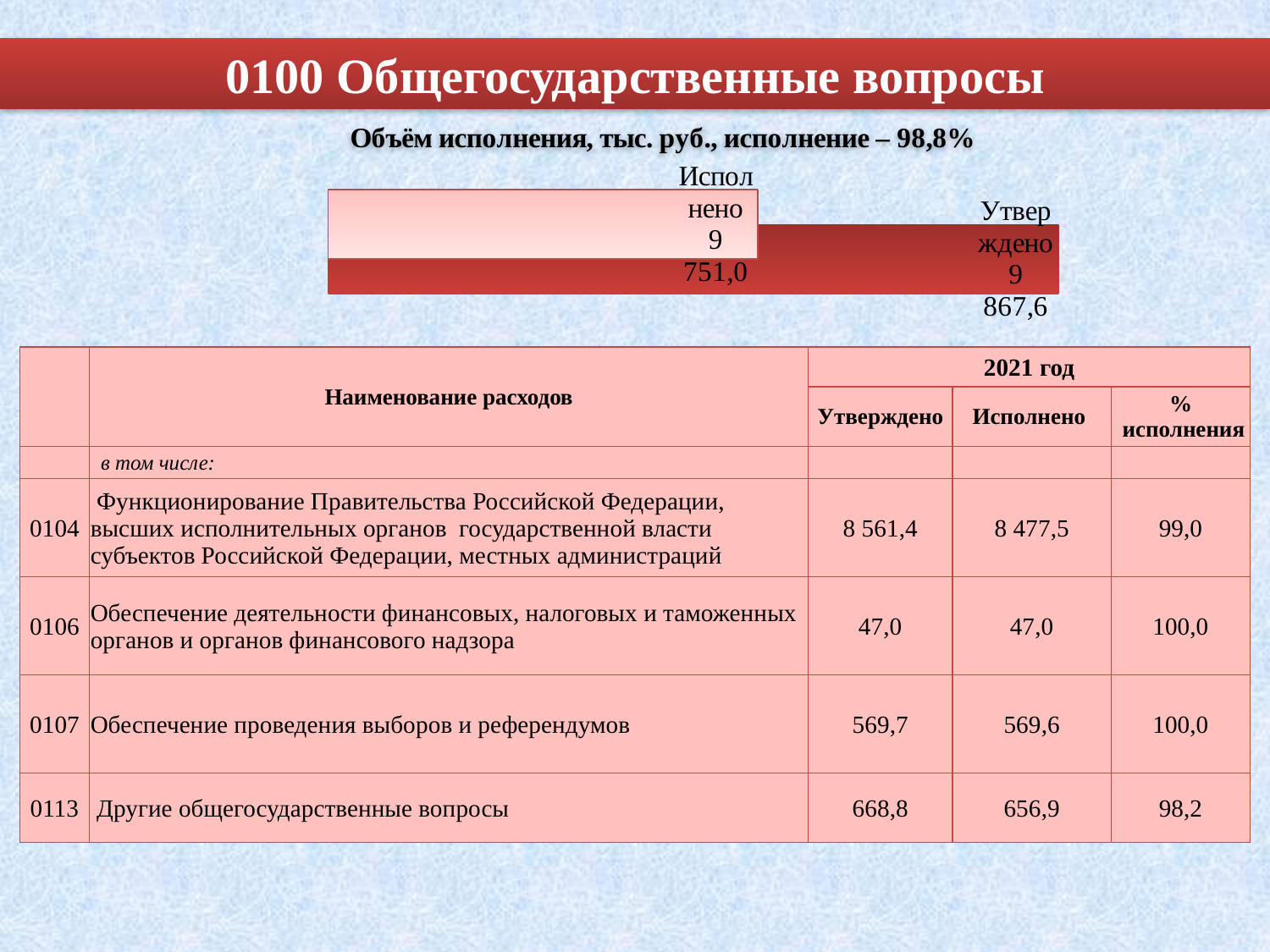
Which bar in the chart is larger, Исполнено or Утверждено? Утверждено What execution percentage is stated in the chart title? 98,8% What is the value of the Утверждено bar in the chart? 9 867,6 Which bar in the chart has the lowest value? Исполнено In what units are the chart values given, according to the chart title? тыс. руб. What is the difference between the Утверждено and Исполнено values in the chart? 116,6 What is the value of the Исполнено bar in the chart? 9 751,0 What is the title of the chart? Объём исполнения, тыс. руб., исполнение – 98,8% How many bars does the chart show? 2 What type of chart is shown on the slide? bar chart